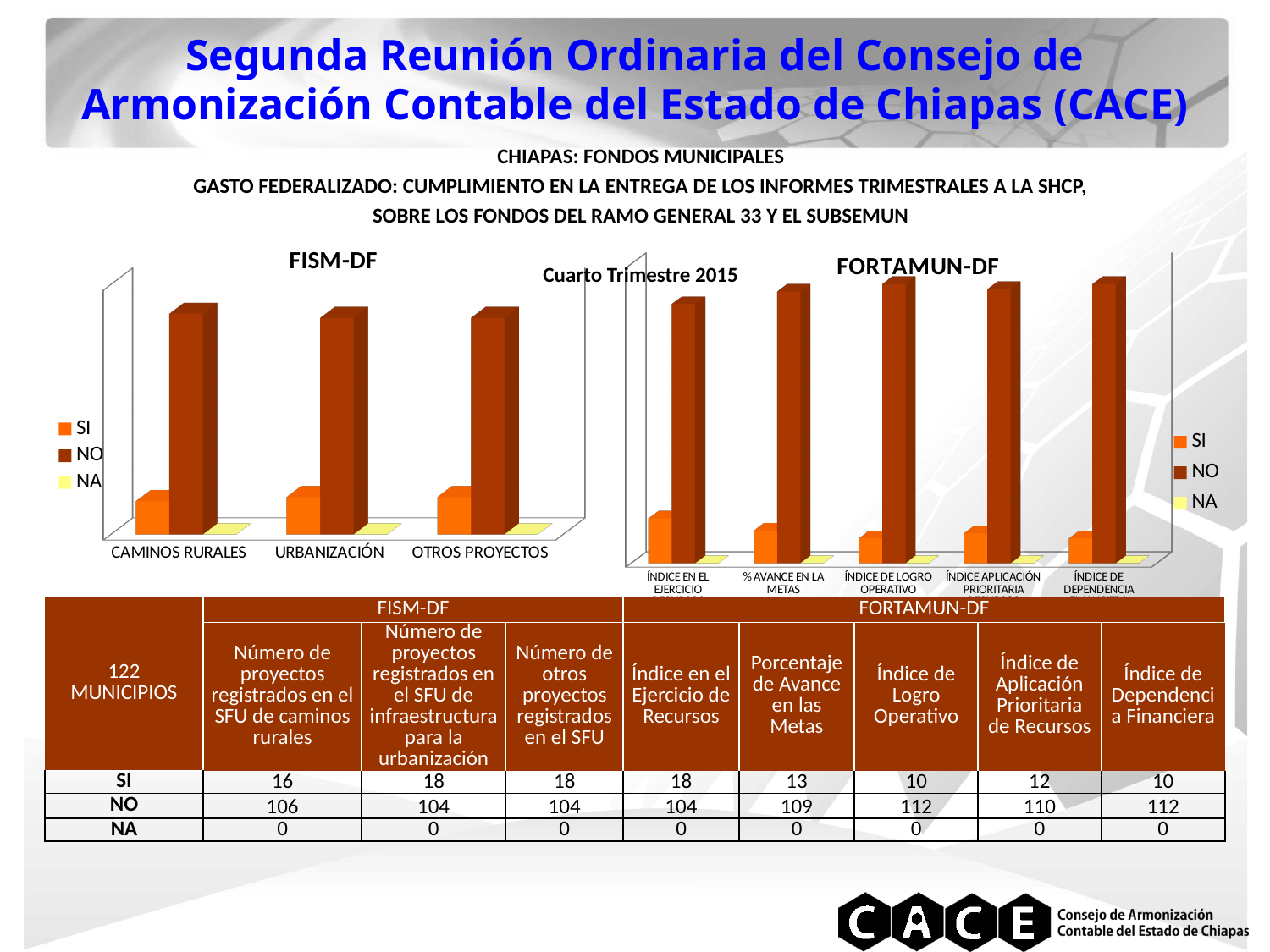
In the FISM-DF chart, what is the NA value for OTROS PROYECTOS? 0 How many categories are shown on the x axis of the FISM-DF chart? 3 How many series does the legend of the FORTAMUN-DF chart list? 3 In the FORTAMUN-DF chart, which category has the highest SI value? ÍNDICE EN EL EJERCICIO DE RECURSOS What are the legend entries of the FISM-DF chart? SI, NO, NA In the FISM-DF chart, what is the difference between the NO value and the SI value for URBANIZACIÓN? 86 In the FORTAMUN-DF chart, which category has the lowest NO value? ÍNDICE EN EL EJERCICIO DE RECURSOS In the FORTAMUN-DF chart, what is the NO value for ÍNDICE DE LOGRO OPERATIVO? 112 How many categories are shown on the x axis of the FORTAMUN-DF chart? 5 In the FISM-DF chart, what is the SI value for CAMINOS RURALES? 16 What kind of chart is the FISM-DF chart? bar chart In the FISM-DF chart, which is larger for CAMINOS RURALES, the SI value or the NO value? NO